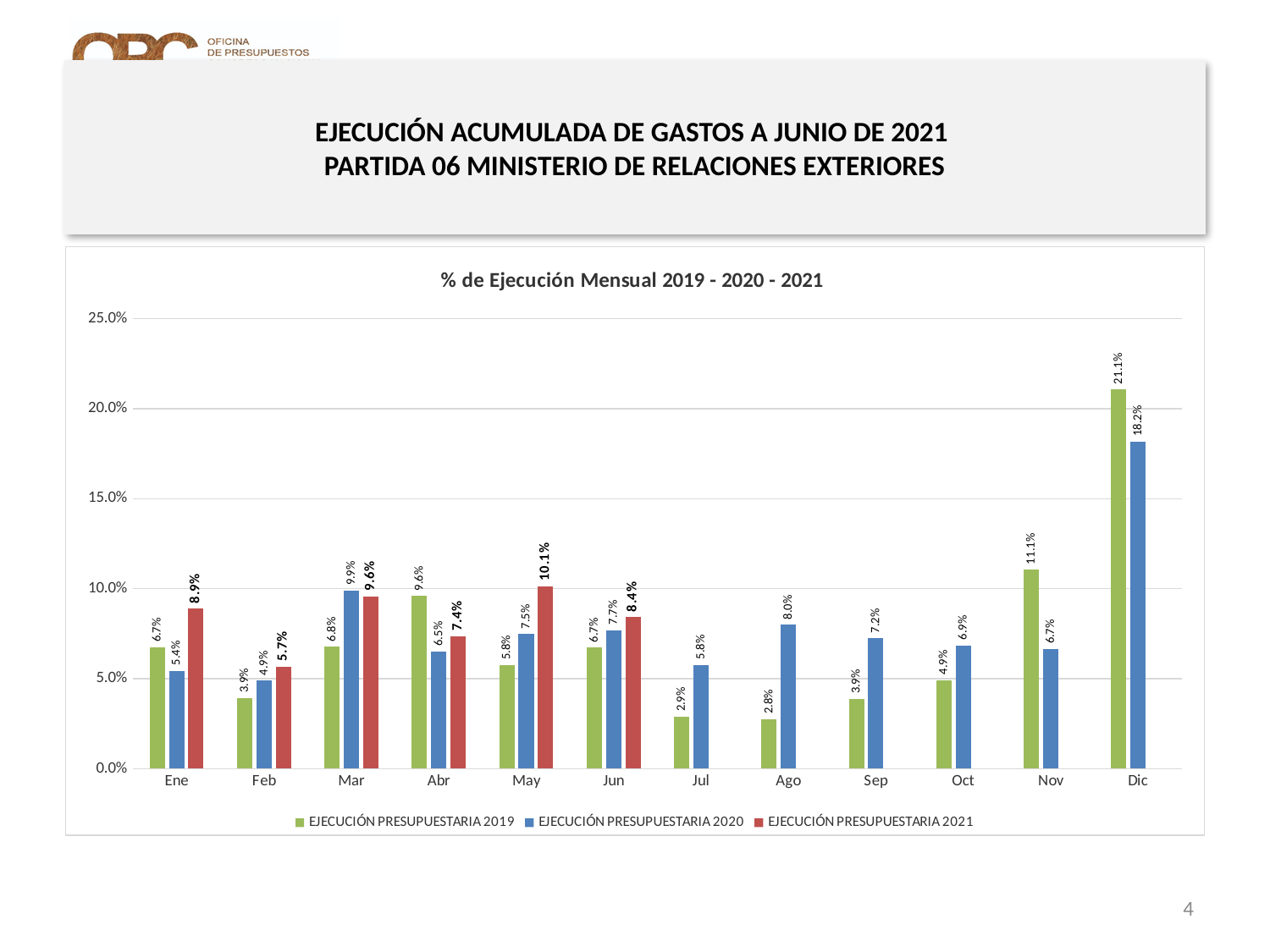
What is the value for EJECUCIÓN PRESUPUESTARIA 2021 in May? 10.1% Which is larger in Abr: EJECUCIÓN PRESUPUESTARIA 2019 or EJECUCIÓN PRESUPUESTARIA 2021? EJECUCIÓN PRESUPUESTARIA 2019 What kind of chart is shown on the slide? Bar chart Which month has the lowest value for EJECUCIÓN PRESUPUESTARIA 2019? Ago What is the difference between the EJECUCIÓN PRESUPUESTARIA 2019 and 2020 values in Dic? 2.9% Which month has the highest value for EJECUCIÓN PRESUPUESTARIA 2021? May What is the title of the chart? % de Ejecución Mensual 2019 - 2020 - 2021 How many series does the legend list? 3 What is the value for EJECUCIÓN PRESUPUESTARIA 2020 in Dic? 18.2% How many months are shown on the x axis? 12 Which month has the highest value for EJECUCIÓN PRESUPUESTARIA 2019? Dic What is the value for EJECUCIÓN PRESUPUESTARIA 2019 in Nov? 11.1%